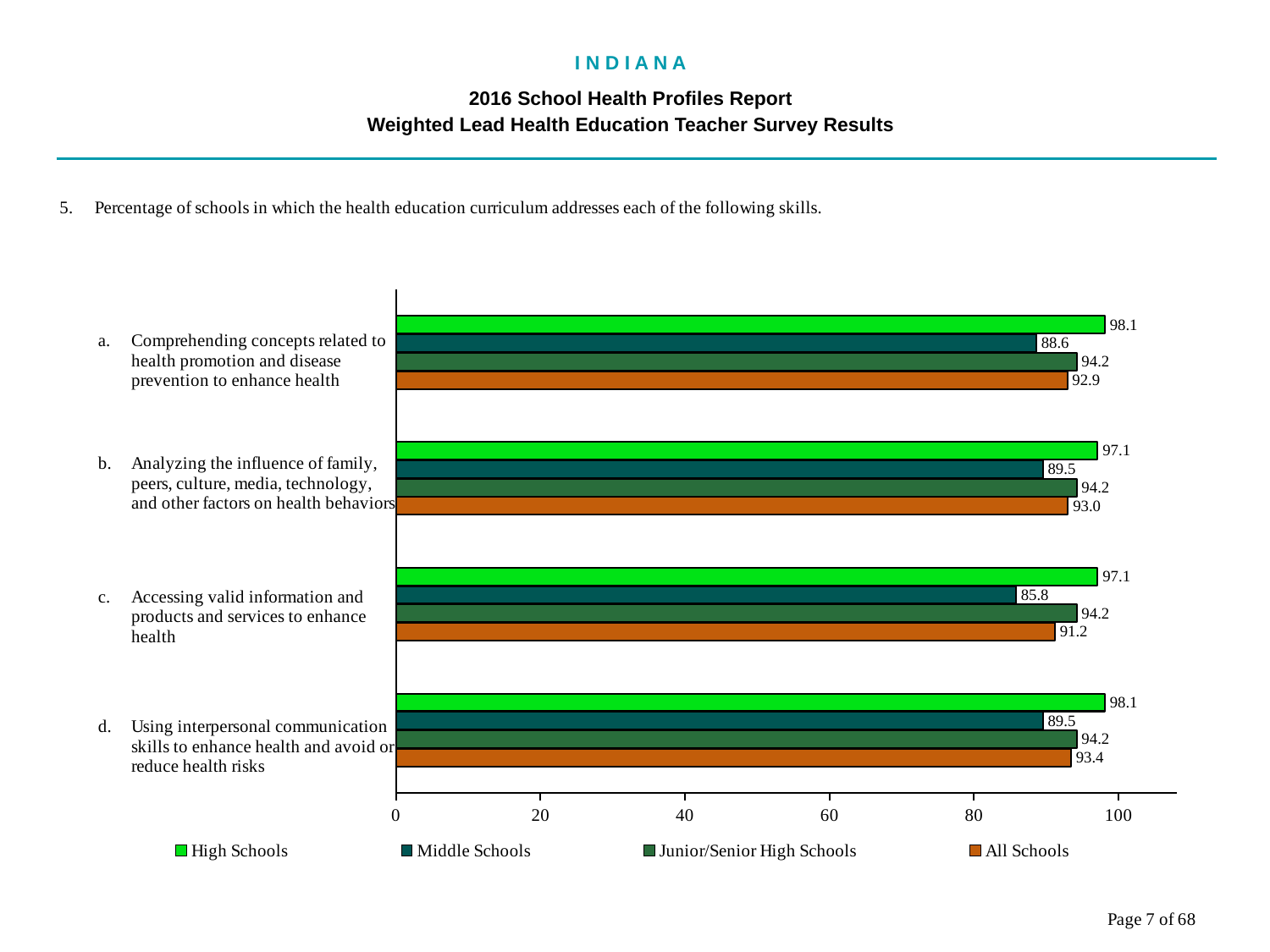
What is the difference between the High Schools and Middle Schools values for skill c? 11.3 What is the value for All Schools for skill d (Using interpersonal communication skills to enhance health and avoid or reduce health risks)? 93.4 How many series does the legend list? 4 Which skill has the lowest Middle Schools value? c. Accessing valid information and products and services to enhance health How many skills (categories) are shown on the chart? 4 Which skill has the lowest All Schools value? c. Accessing valid information and products and services to enhance health What is the difference between the High Schools and All Schools values for skill a? 5.2 What is the value for Junior/Senior High Schools for skill b (Analyzing the influence of family, peers, culture, media, technology, and other factors on health behaviors)? 94.2 What is the value for High Schools for skill a (Comprehending concepts related to health promotion and disease prevention to enhance health)? 98.1 For skill b, which is larger: the Middle Schools value or the All Schools value? All Schools What is the value for Middle Schools for skill c (Accessing valid information and products and services to enhance health)? 85.8 What kind of chart is shown on the slide? Bar chart